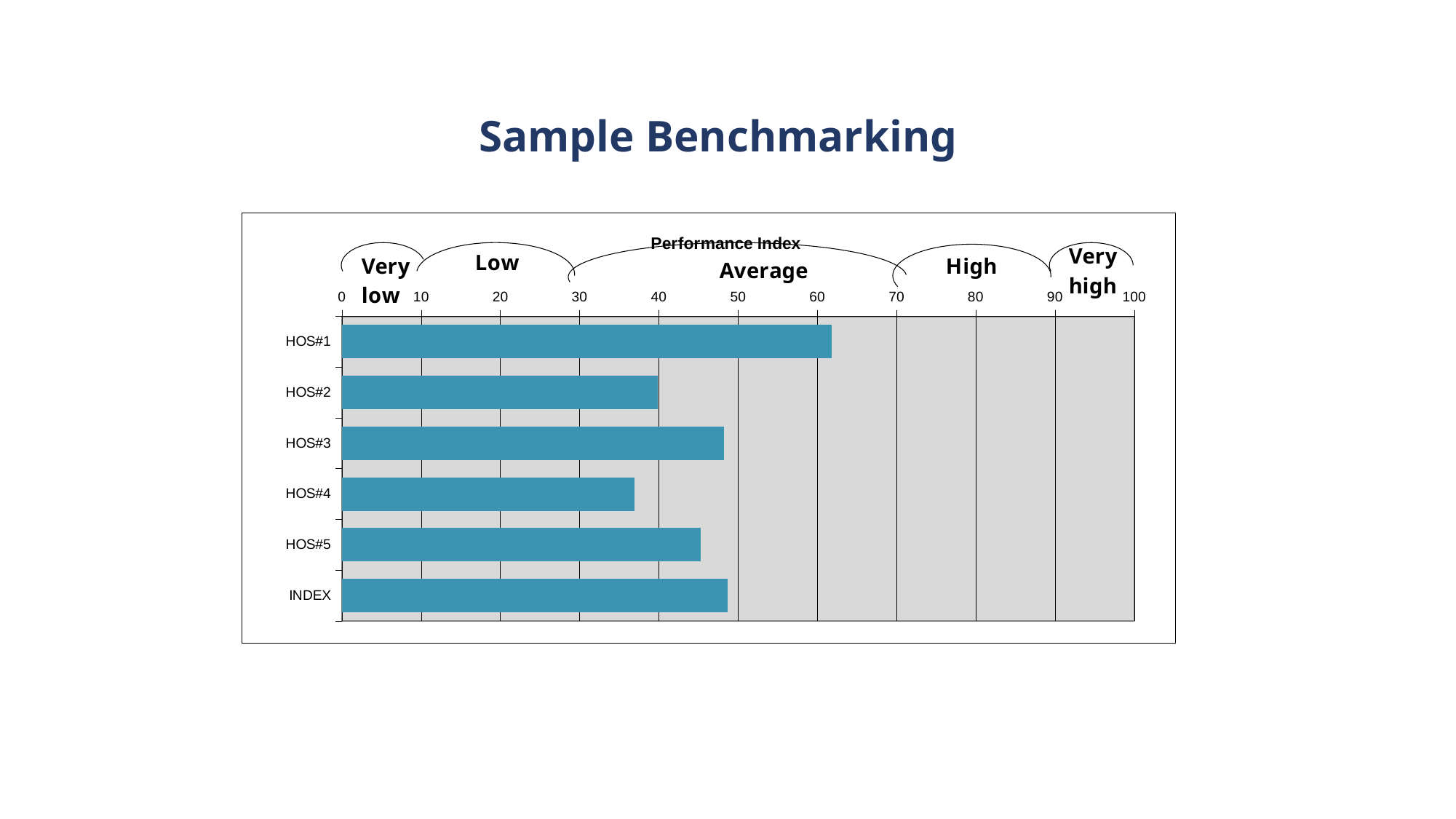
Is the value for HOS#1 greater or less than 50? greater Is the value for HOS#4 greater or less than 40? less Is the value for INDEX greater or less than 40? greater Which category has the highest value in the chart? HOS#1 How many categories (bars) are plotted in the chart? 6 What is the title of the chart? Performance Index Which category has the lowest value in the chart? HOS#4 Which has the larger value, HOS#1 or HOS#2? HOS#1 How many performance bands are labelled above the x axis of the chart? 5 What kind of chart is shown on the slide? bar chart Which has the larger value, HOS#4 or HOS#5? HOS#5